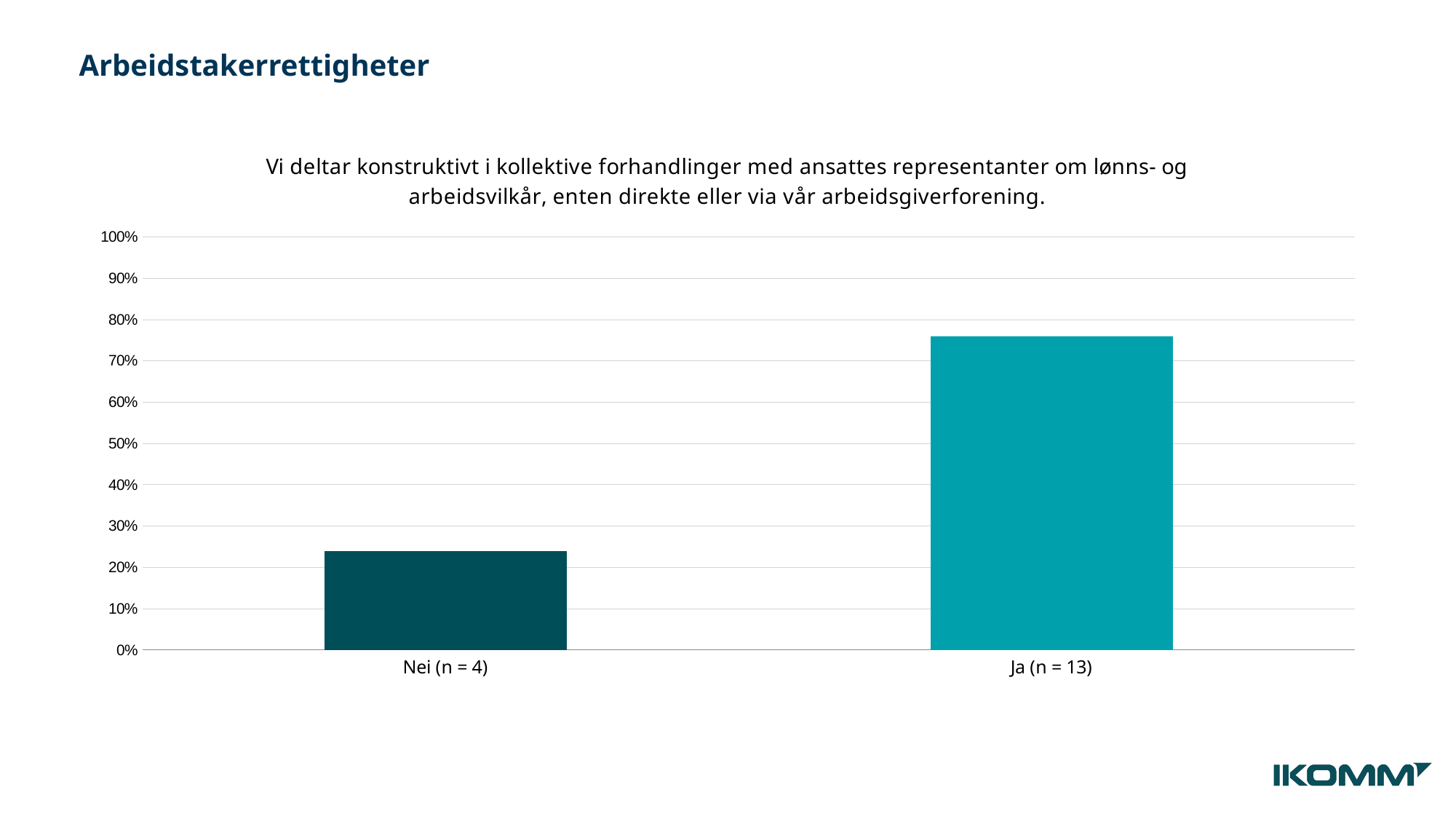
Is the value for Nei (n = 4) greater or less than 10%? greater How many categories are shown on the x axis of the chart? 2 How many respondents answered Ja according to the category label? 13 What is the slide's heading above the chart? Arbeidstakerrettigheter Is the value for Ja (n = 13) greater or less than 80%? less Which category has the highest bar? Ja (n = 13) What kind of chart is shown on the slide? bar chart Which bar is taller, Nei or Ja? Ja Which category has the lowest bar? Nei (n = 4) Is the value for Ja (n = 13) greater or less than 50%? greater